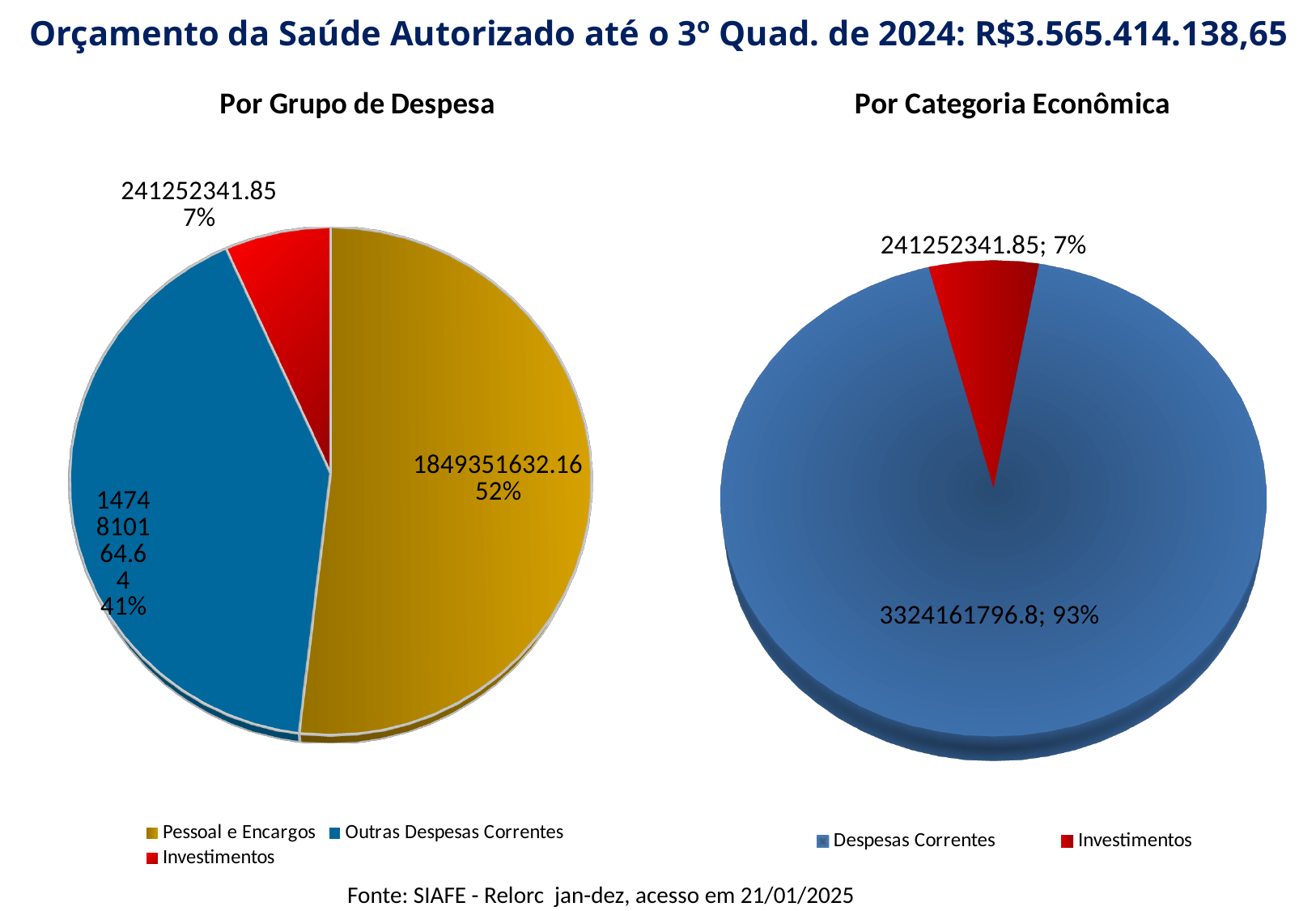
In the 'Por Grupo de Despesa' chart, which category has the largest slice? Pessoal e Encargos In the 'Por Grupo de Despesa' chart, what value is shown for Pessoal e Encargos? 1849351632.16 In the 'Por Categoria Econômica' chart, which is larger, Despesas Correntes or Investimentos? Despesas Correntes In the 'Por Grupo de Despesa' chart, what share of the pie does Outras Despesas Correntes represent? 41% What kind of chart is the 'Por Categoria Econômica' chart? Pie chart In the 'Por Categoria Econômica' chart, what share of the pie does Investimentos represent? 7% In the 'Por Categoria Econômica' chart, what value is shown for Despesas Correntes? 3324161796.8 In the 'Por Grupo de Despesa' chart, what value is shown for Investimentos? 241252341.85 How many categories does the 'Por Grupo de Despesa' chart show? 3 How many entries does the legend of the 'Por Categoria Econômica' chart list? 2 In the 'Por Grupo de Despesa' chart, which category has the smallest slice? Investimentos In the 'Por Grupo de Despesa' chart, what share of the pie does Pessoal e Encargos represent? 52%